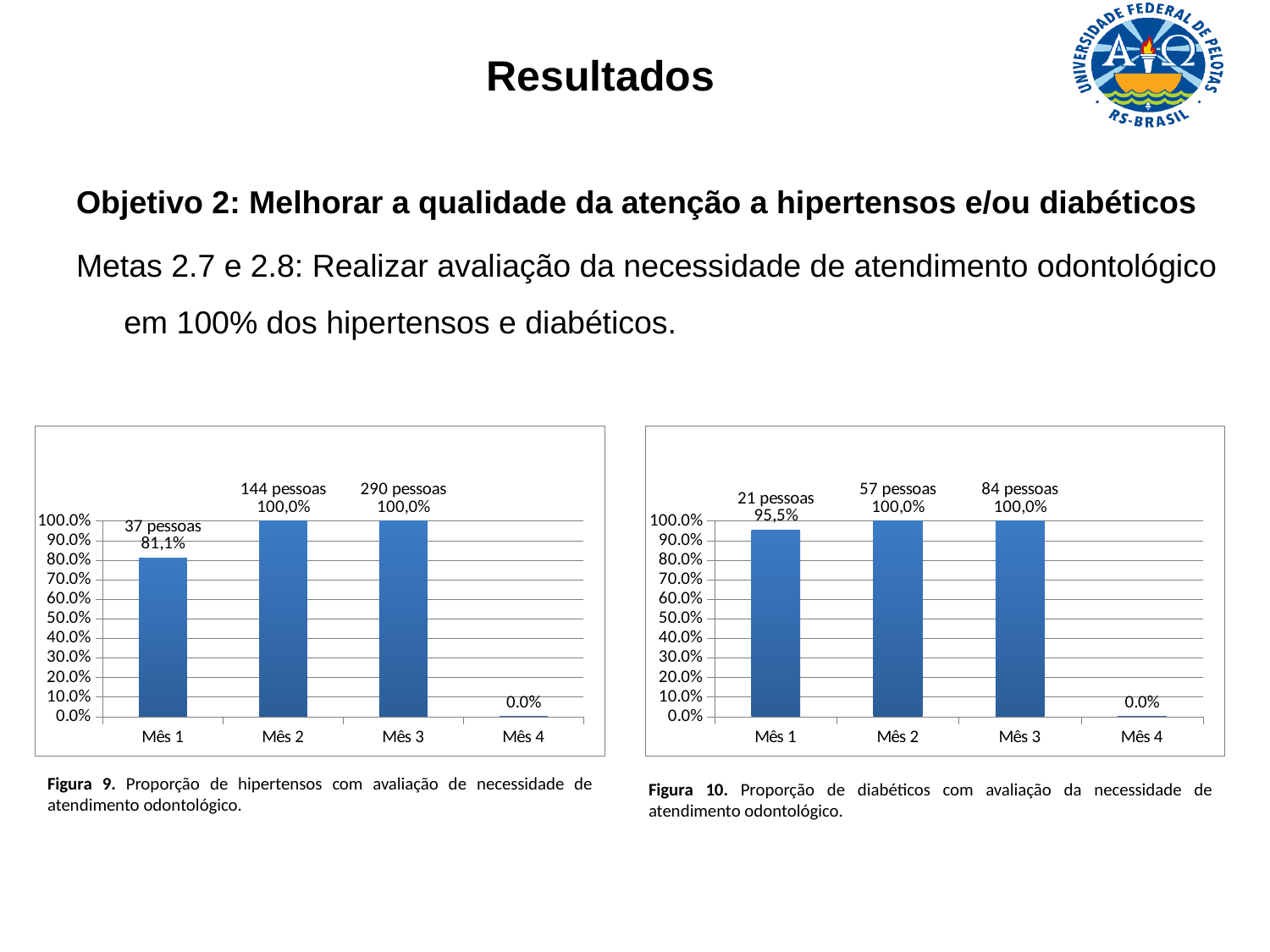
In the right chart (Figura 10), what is the value for Mês 1? 95,5% In the left chart (Figura 9), is the value for Mês 1 greater or less than 80.0%? greater In the right chart (Figura 10), how many people does the Mês 2 label report? 57 pessoas In the left chart (Figura 9), how many people does the Mês 3 label report? 290 pessoas In the left chart (Figura 9), which month has the lowest value? Mês 4 Which is larger: the Mês 1 value in the left chart (Figura 9) or the Mês 1 value in the right chart (Figura 10)? Right chart (Figura 10) What type of chart is the right chart (Figura 10)? Bar chart How many months (categories) are shown on the x axis of the left chart (Figura 9)? 4 In the left chart (Figura 9), what is the value for Mês 1? 81,1% In the left chart (Figura 9), what is the difference between the values for Mês 2 and Mês 1? 18,9% In the right chart (Figura 10), what is the difference between the values for Mês 3 and Mês 1? 4,5% In the right chart (Figura 10), which month has the lowest value? Mês 4